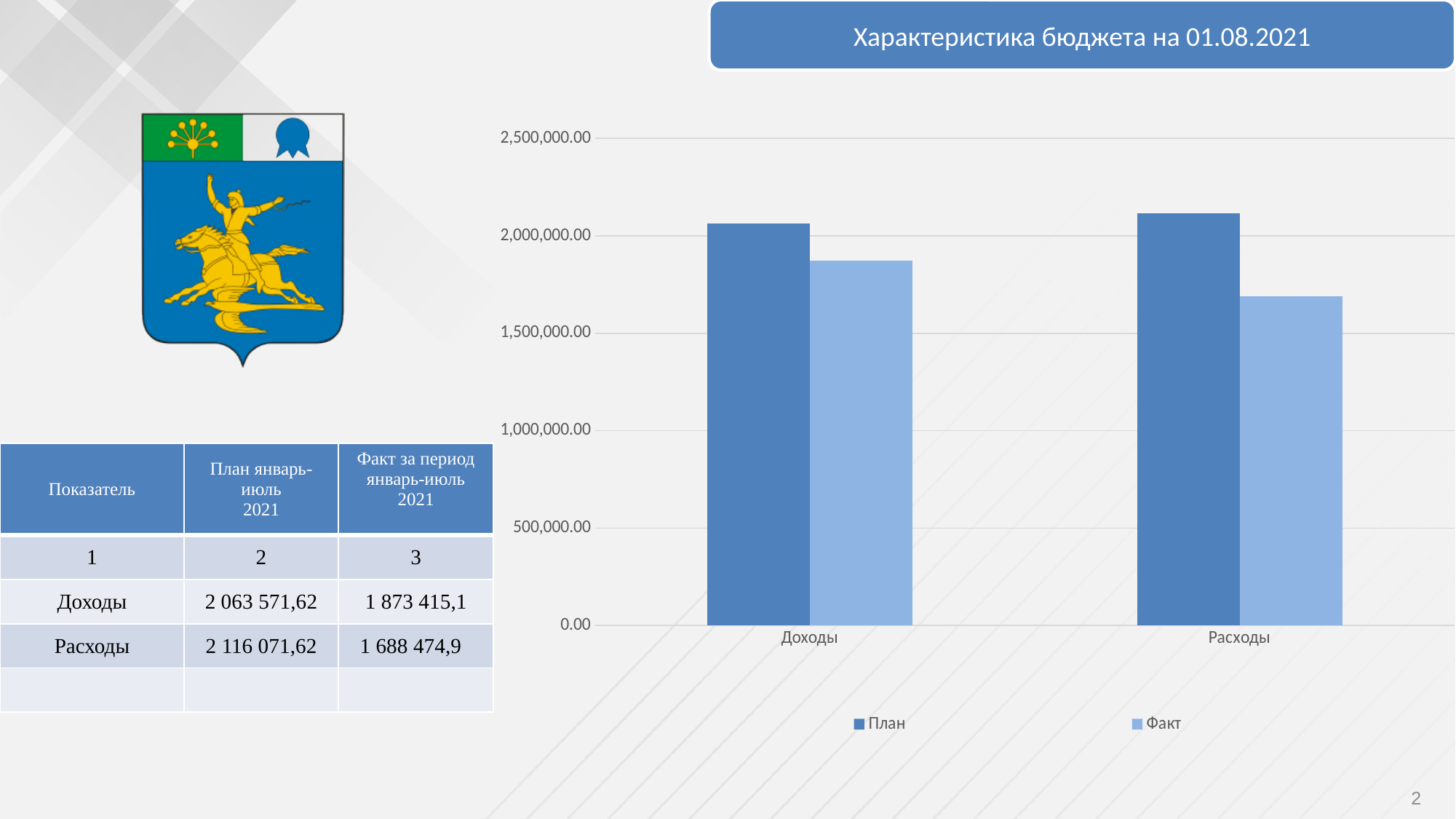
Which bar in the chart is the tallest? План for Расходы How many categories are shown on the x axis of the chart? 2 What kind of chart is shown on the slide? bar chart Is the План value for Расходы greater or less than 2,000,000.00? greater What is the План value for Доходы? 2 063 571,62 What are the two series named in the chart legend? План and Факт Which is larger, the Факт value for Доходы or the Факт value for Расходы? Факт for Доходы Which bar in the chart is the shortest? Факт for Расходы What is the title shown above the chart? Характеристика бюджета на 01.08.2021 What is the Факт value for Расходы? 1 688 474,9 How many series does the chart legend list? 2 Is the Факт value for Доходы greater or less than 2,000,000.00? less